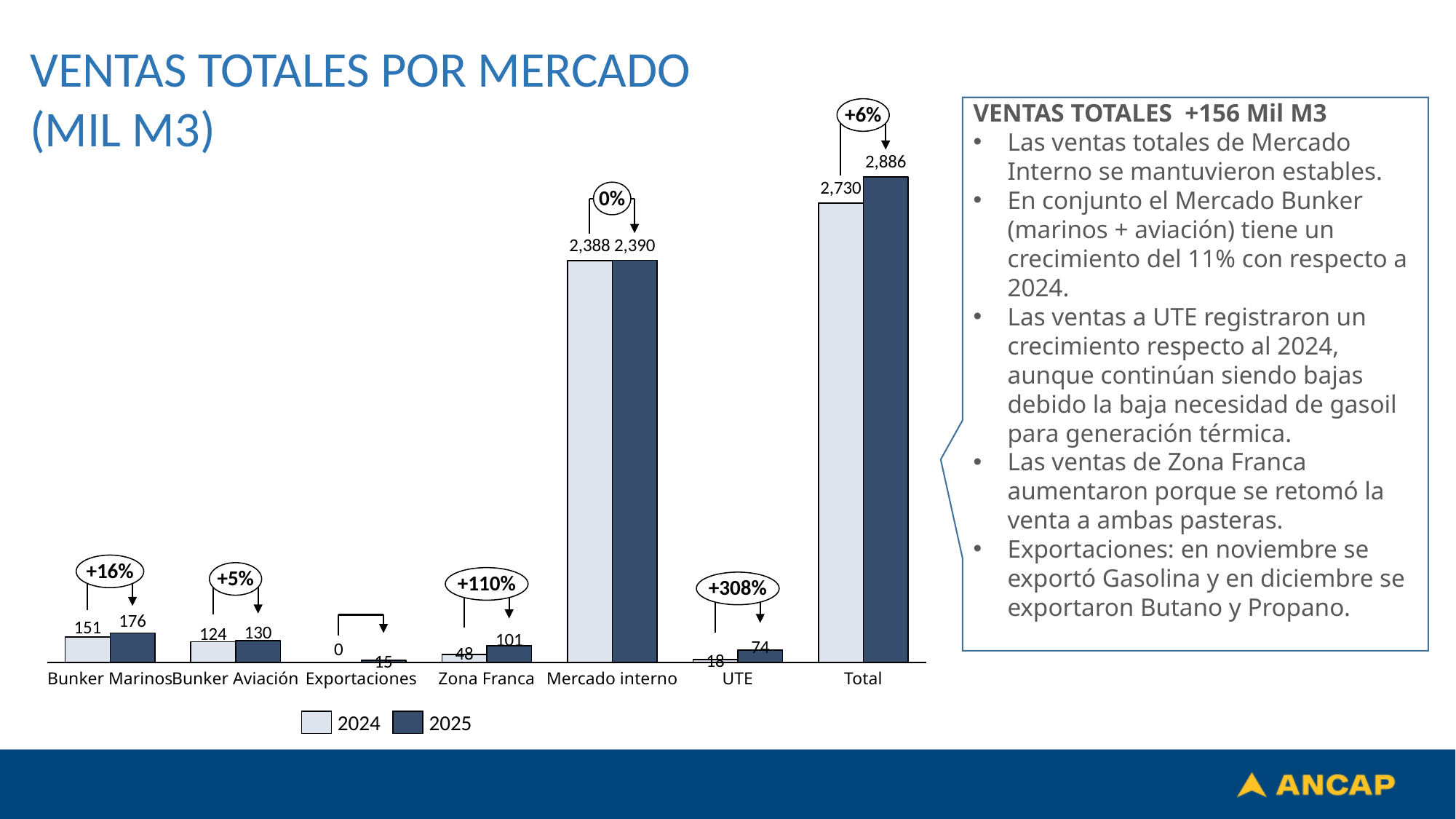
How many series does the legend list? 2 What is the difference between the 2025 and 2024 values for Total? 156 What kind of chart is shown on the slide? Bar chart Which category has the lowest 2024 value? Exportaciones What is the 2024 value for Bunker Marinos? 151 What is the 2025 value for Zona Franca? 101 How many categories are shown on the x axis? 7 What is the 2025 value for Mercado interno? 2,390 What percentage change is shown above the UTE bars? +308% Excluding the Total category, which market has the highest 2025 value? Mercado interno Which is larger, the 2025 value for Bunker Aviación or the 2025 value for Bunker Marinos? Bunker Marinos What is the 2024 value for UTE? 18